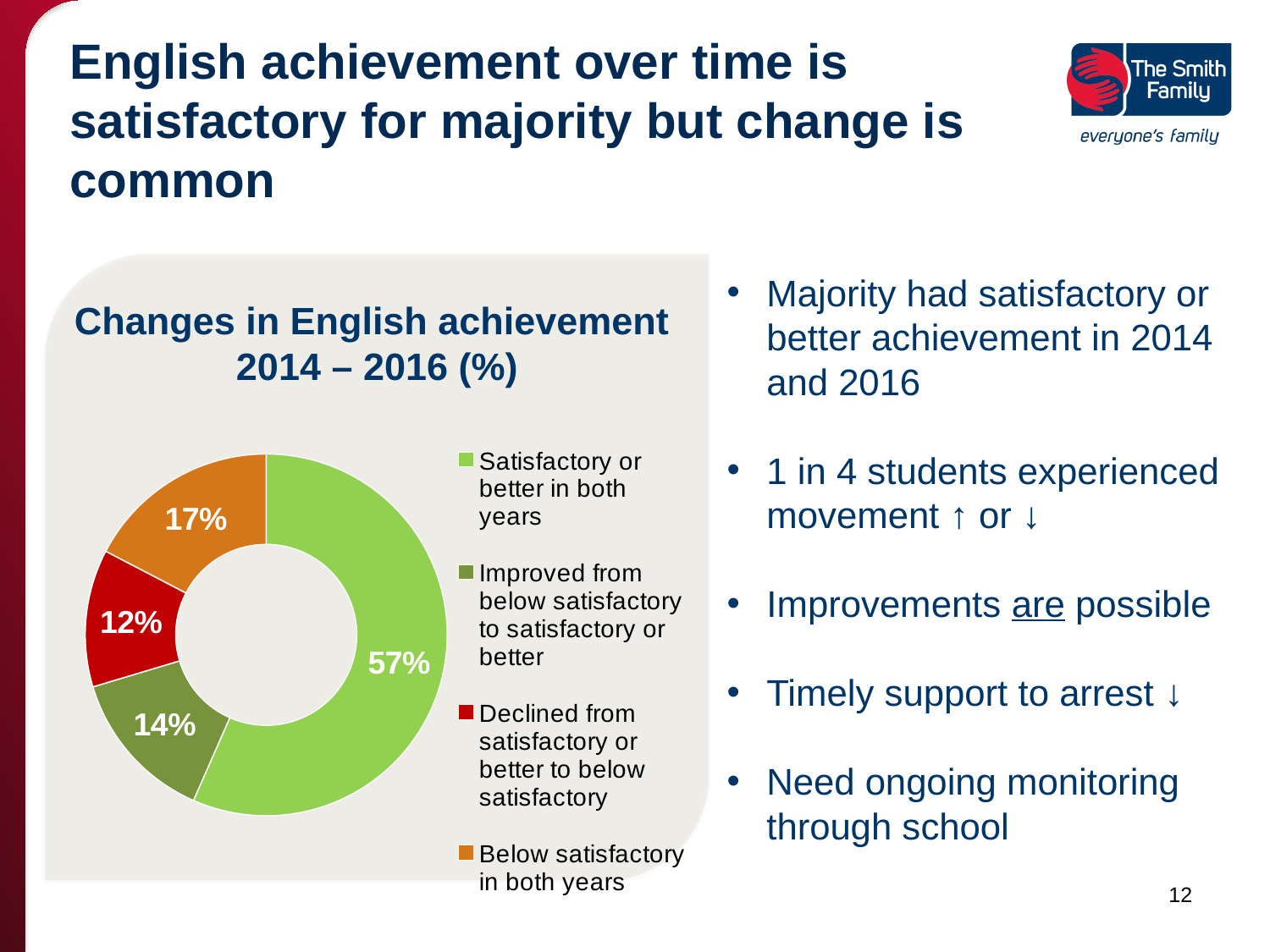
What percentage of students declined from satisfactory or better to below satisfactory? 12% Which category has the smallest share of the chart? Declined from satisfactory or better to below satisfactory Which category has the largest share of the chart? Satisfactory or better in both years What colour represents the 'Below satisfactory in both years' category? Orange How many categories does the chart show? 4 What percentage of students were below satisfactory in both years? 17% What is the difference in percentage points between students satisfactory or better in both years and students below satisfactory in both years? 40 Which is larger: the share that improved or the share that declined? Improved What kind of chart is shown on the slide? Doughnut (pie) chart What is the title of the chart? Changes in English achievement 2014 – 2016 (%) What percentage of students improved from below satisfactory to satisfactory or better? 14% What percentage of students were satisfactory or better in both years? 57%